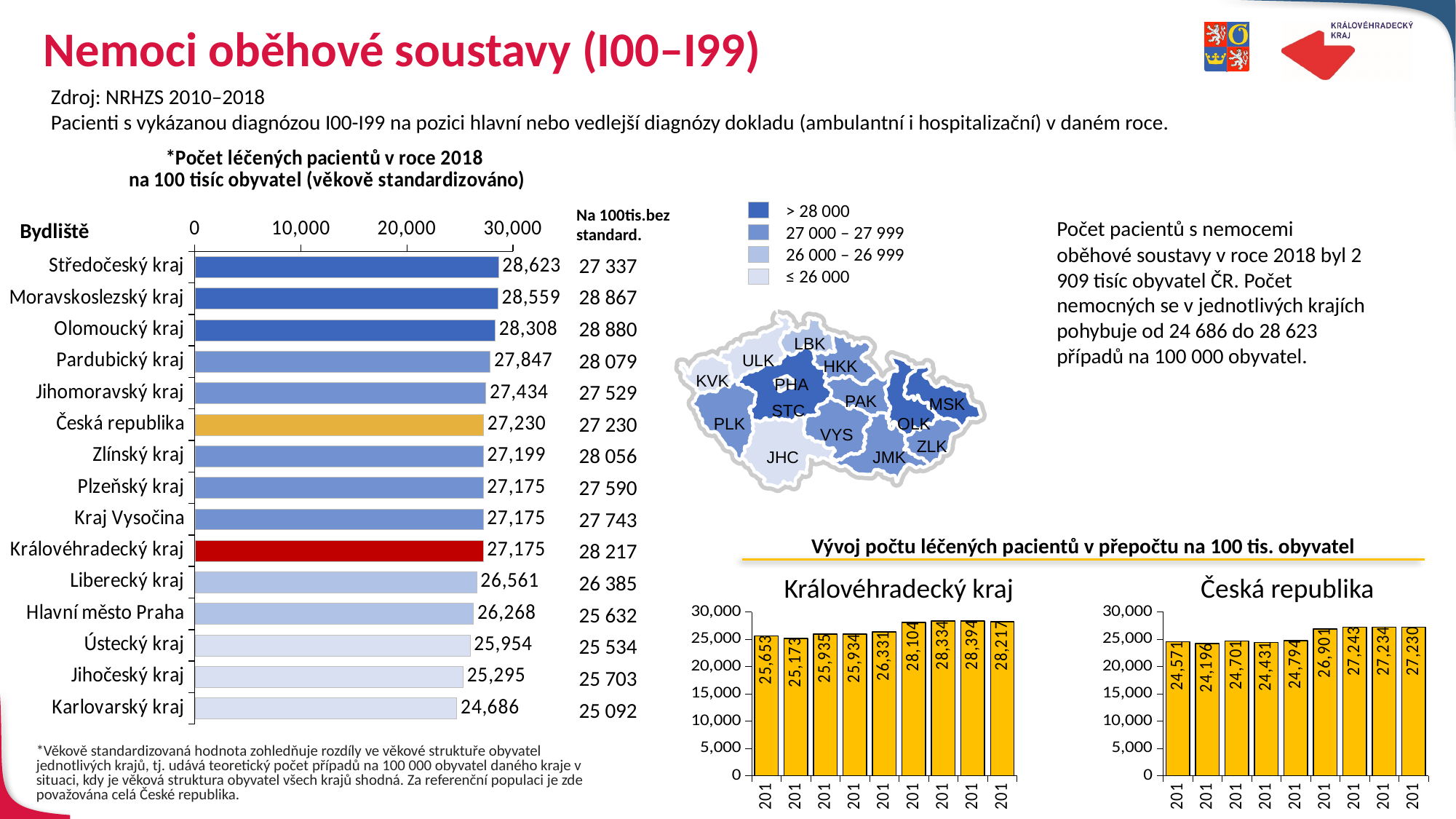
In the bar chart 'Počet léčených pacientů v roce 2018 na 100 tisíc obyvatel', which has the larger value, Liberecký kraj or Hlavní město Praha? Liberecký kraj In the bar chart 'Počet léčených pacientů v roce 2018 na 100 tisíc obyvatel', what is the value for Královéhradecký kraj? 27,175 In the small chart titled 'Královéhradecký kraj' at the bottom right, what is the highest value shown? 28,394 In the small chart titled 'Královéhradecký kraj' at the bottom right, how many bars are shown? 9 In the bar chart 'Počet léčených pacientů v roce 2018 na 100 tisíc obyvatel', what is the difference between the values for Středočeský kraj and Karlovarský kraj? 3,937 In the small chart titled 'Česká republika' at the bottom right, what is the difference between the last bar (27,230) and the first bar (24,571)? 2,659 In the bar chart 'Počet léčených pacientů v roce 2018 na 100 tisíc obyvatel', what colour is the bar for Královéhradecký kraj? Red In the small chart titled 'Česká republika' at the bottom right, do the values generally rise or fall from left to right? Rise In the bar chart 'Počet léčených pacientů v roce 2018 na 100 tisíc obyvatel', which region has the lowest value? Karlovarský kraj In the bar chart 'Počet léčených pacientů v roce 2018 na 100 tisíc obyvatel', what is the value for Středočeský kraj? 28,623 In the bar chart 'Počet léčených pacientů v roce 2018 na 100 tisíc obyvatel', how many categories (bars) are shown? 15 In the bar chart 'Počet léčených pacientů v roce 2018 na 100 tisíc obyvatel', which region has the highest value? Středočeský kraj